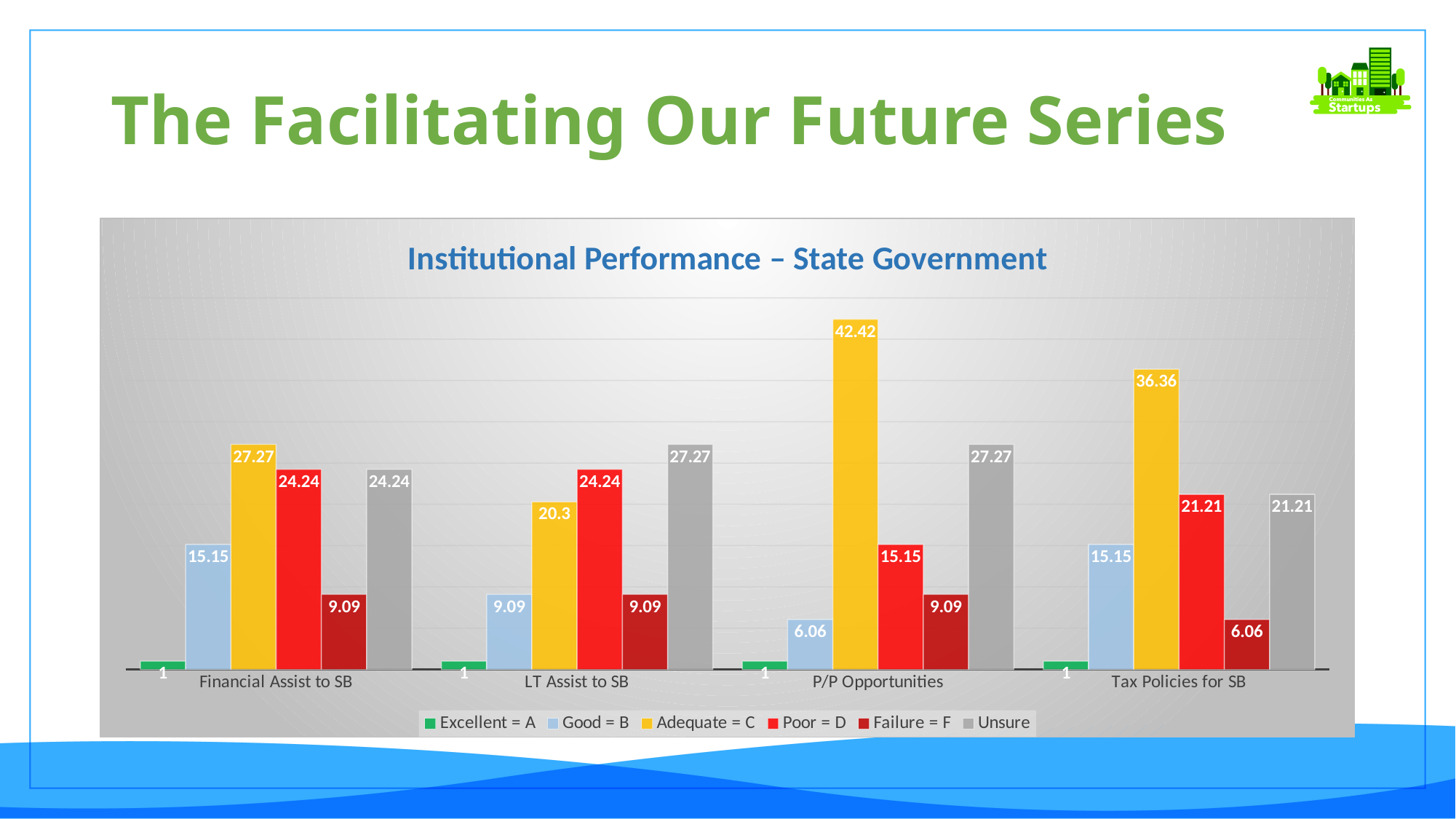
Which category has the lowest Good = B value? P/P Opportunities What is the value for Adequate = C in the P/P Opportunities category? 42.42 What is the value for Good = B in the LT Assist to SB category? 9.09 What is the title of the chart? Institutional Performance – State Government What is the value for Unsure in the Tax Policies for SB category? 21.21 What kind of chart is shown on the slide? Bar chart Which category has the highest Adequate = C value? P/P Opportunities How many categories are shown on the x axis? 4 What is the value for Poor = D in the Financial Assist to SB category? 24.24 What is the difference between the Adequate = C values for P/P Opportunities and Tax Policies for SB? 6.06 Which is larger: the Poor = D value for LT Assist to SB or the Poor = D value for P/P Opportunities? LT Assist to SB How many series does the legend list? 6